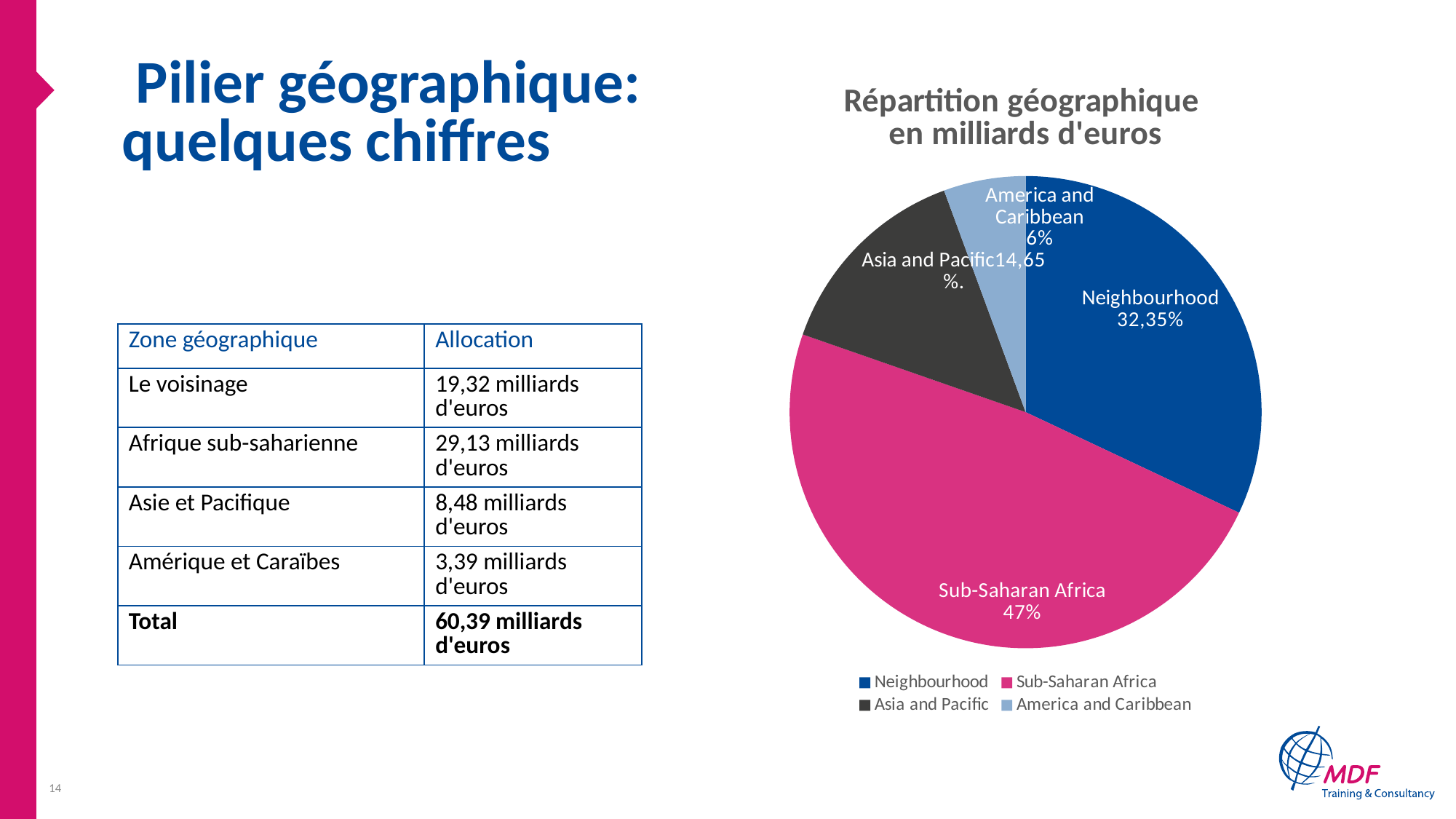
What percentage is shown for Asia and Pacific in the pie chart? 14,65% What is the title of the pie chart? Répartition géographique en milliards d'euros What percentage is shown for America and Caribbean in the pie chart? 6% Which region has the smallest slice of the pie chart? America and Caribbean How many entries does the pie chart's legend list? 4 Which region has the largest slice of the pie chart? Sub-Saharan Africa By how many percentage points does the Sub-Saharan Africa share exceed the Neighbourhood share? 14,65% What percentage is labelled on the Sub-Saharan Africa slice? 47% What percentage share does the Neighbourhood slice show in the pie chart? 32,35% What type of chart is shown on the slide? Pie chart Which slice is larger in the pie chart: Neighbourhood or Asia and Pacific? Neighbourhood How many slices does the pie chart have? 4